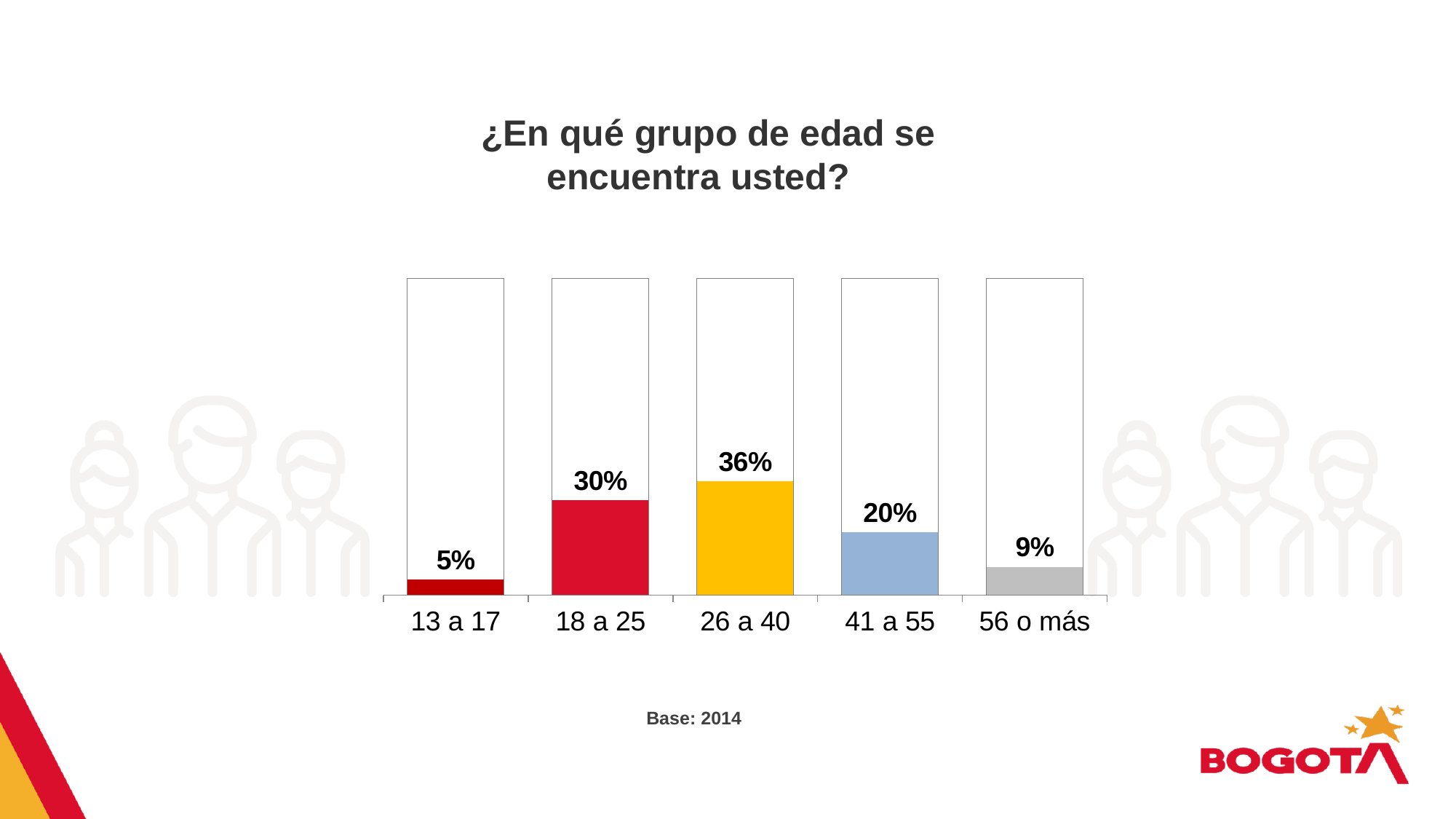
What is the title of the chart? ¿En qué grupo de edad se encuentra usted? What is the difference between the 41 a 55 and 56 o más percentages? 11% Which age group has the highest percentage? 26 a 40 What kind of chart is shown on the slide? Bar chart How many age groups are shown on the chart? 5 What percentage is shown for the 56 o más age group? 9% What percentage of respondents are in the 26 a 40 age group? 36% What base size is stated below the chart? 2014 Which is larger, the value for 18 a 25 or the value for 41 a 55? 18 a 25 Which age group has the lowest percentage? 13 a 17 What is the difference between the 26 a 40 and 18 a 25 percentages? 6% What is the value shown for the 13 a 17 age group? 5%